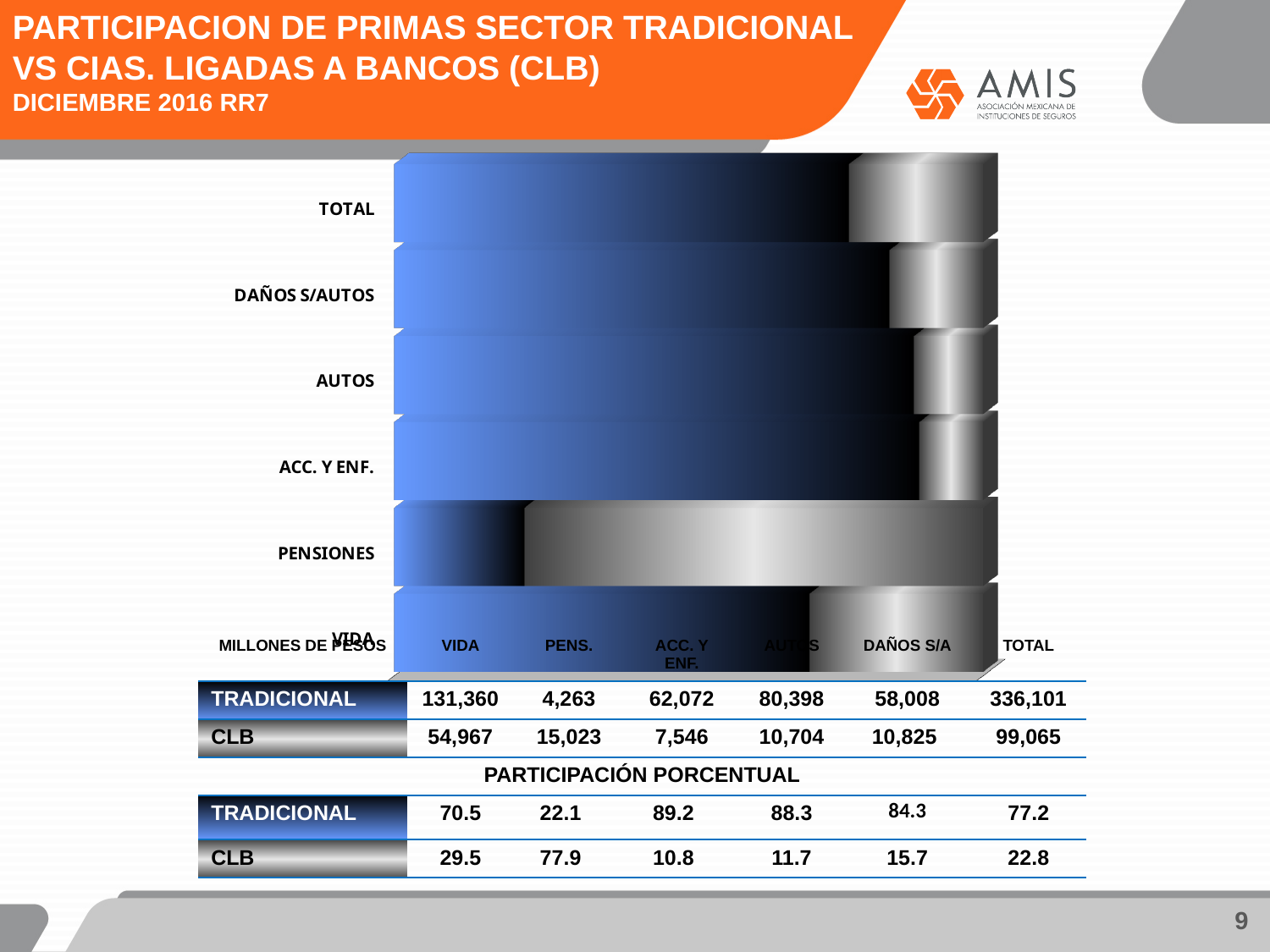
In which category does CLB have its largest percentage share? PENSIONES What kind of chart is shown on the slide? Bar chart (horizontal stacked) What is the CLB percentage share for DAÑOS S/A? 15.7 How many categories are plotted on the chart? 6 What is the TRADICIONAL percentage share for AUTOS? 88.3 Which colour represents the TRADICIONAL series in the chart? Blue What is the TRADICIONAL value for VIDA in millions of pesos? 131,360 In which category does TRADICIONAL have its smallest percentage share? PENSIONES What is the difference between the TRADICIONAL and CLB TOTAL values in millions of pesos? 237,036 How many series does the chart show? 2 What is the CLB value for PENS. in millions of pesos? 15,023 Which is larger for VIDA, the TRADICIONAL value or the CLB value? TRADICIONAL